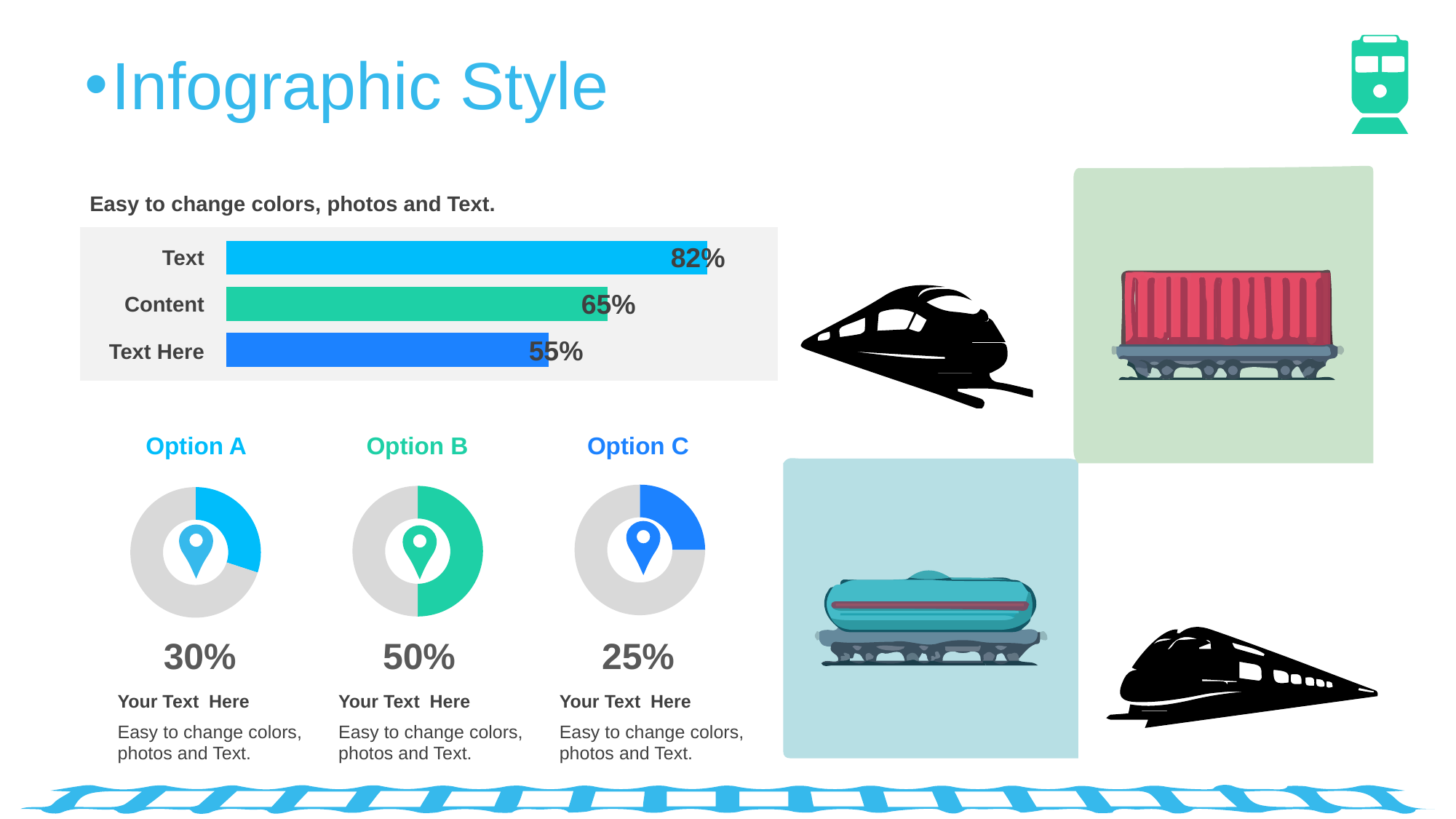
In the horizontal bar chart, what is the difference between the values for Text and Content? 17% In the horizontal bar chart, what is the value for Content? 65% In the horizontal bar chart, which category has the lowest value? Text Here In the horizontal bar chart, which category has the highest value? Text In the donut chart for Option C, what percentage is shown? 25% In the horizontal bar chart, which is larger, the value for Content or the value for Text Here? Content In the donut chart for Option B, what percentage is shown? 50% What kind of chart is shown at the top left of the slide? Bar chart In the horizontal bar chart, what is the value for Text Here? 55% What is the difference between the percentages shown for Option A and Option C in the donut charts? 5% Among the three donut charts (Option A, Option B, Option C), which option has the lowest percentage? Option C How many bars are in the horizontal bar chart? 3